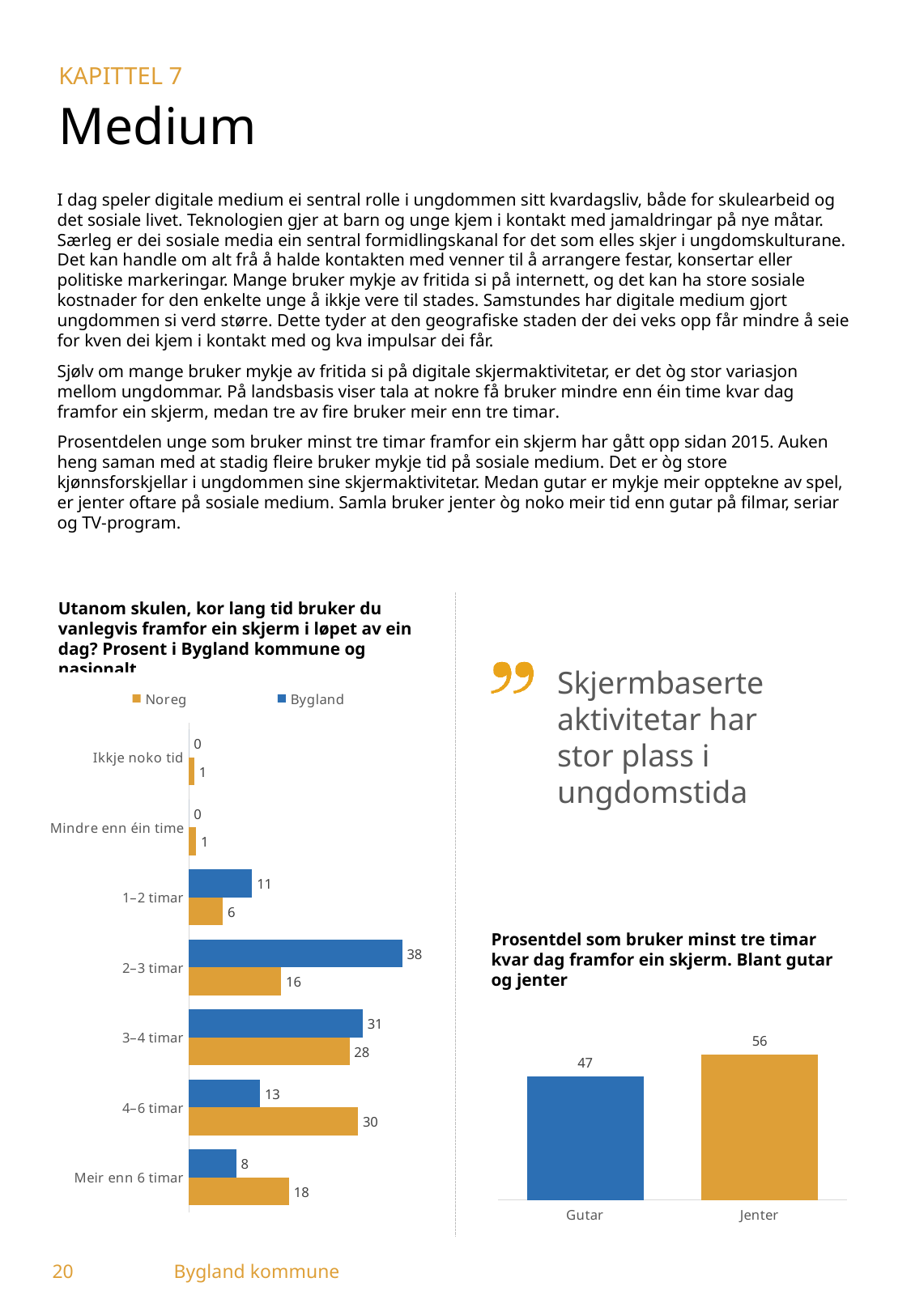
In the left chart, what is the Noreg value for 4–6 timar? 30 In the left chart, what is the difference between the Bygland and Noreg values for 2–3 timar? 22 In the left chart, which category has the highest Noreg value? 4–6 timar In the left chart, what is the Noreg value for Meir enn 6 timar? 18 In the right chart (Prosentdel som bruker minst tre timar kvar dag framfor ein skjerm), what is the value for Jenter? 56 What kind of chart is the right chart? Bar chart In the right chart, what is the difference between the values for Jenter and Gutar? 9 How many series does the legend of the left chart list? 2 In the left chart, what is the Bygland value for 2–3 timar? 38 In the left chart, which category has the highest Bygland value? 2–3 timar In the left chart, which is larger for 4–6 timar: the Noreg value or the Bygland value? Noreg How many categories does the left chart show? 7